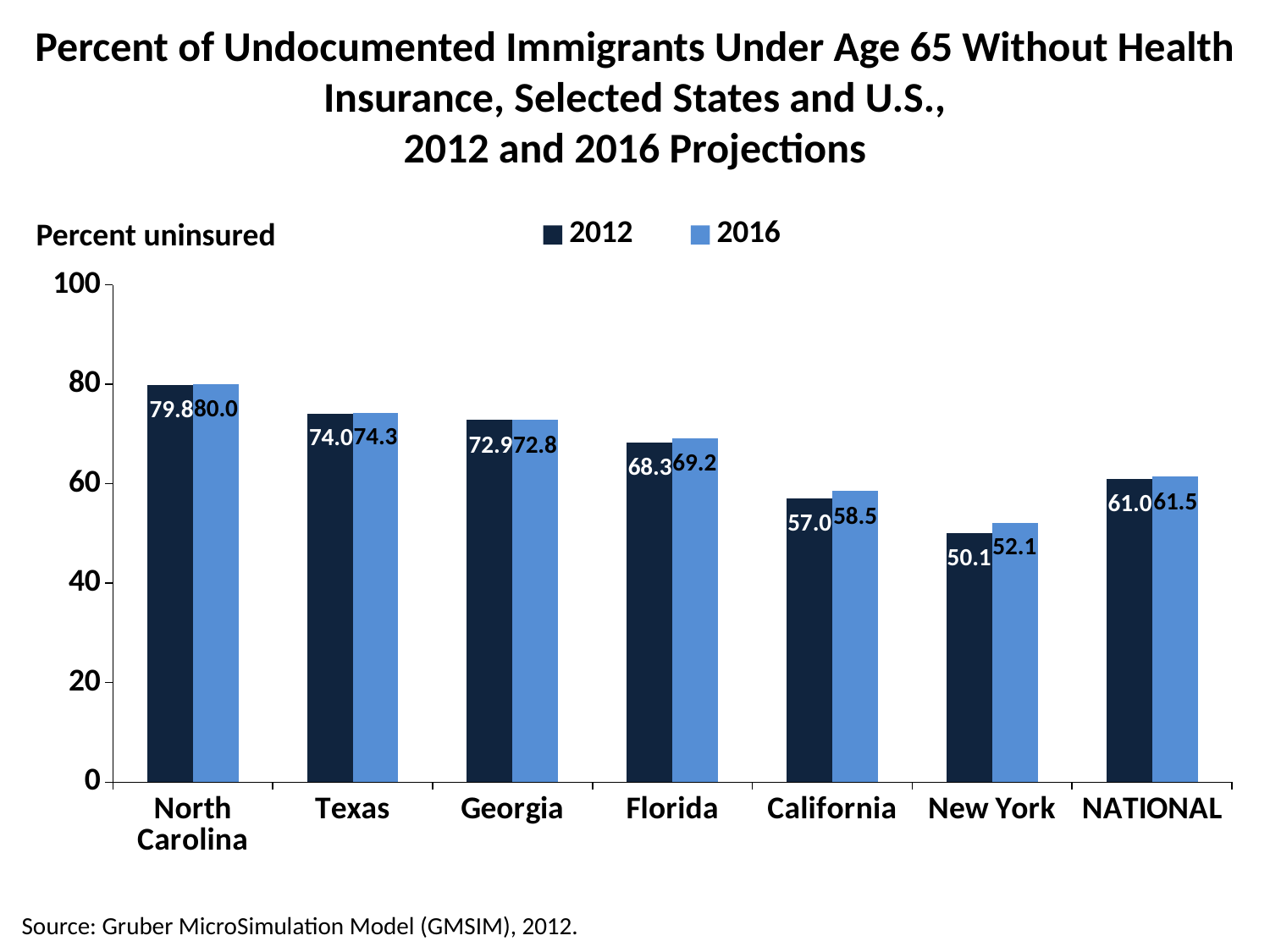
Which is larger for Georgia, the 2012 value or the 2016 value? 2012 What is the label on the vertical axis? Percent uninsured What kind of chart is shown on the slide? bar chart What is the difference between the 2016 and 2012 values for New York? 2.0 How many series does the legend list? 2 How many categories are shown on the x axis? 7 Which category has the highest 2016 value? North Carolina What is the 2016 value for California? 58.5 Which category has the lowest 2012 value? New York What is the 2012 value for NATIONAL? 61.0 What is the 2012 value for North Carolina? 79.8 Is the 2012 value for Florida greater or less than 60? greater